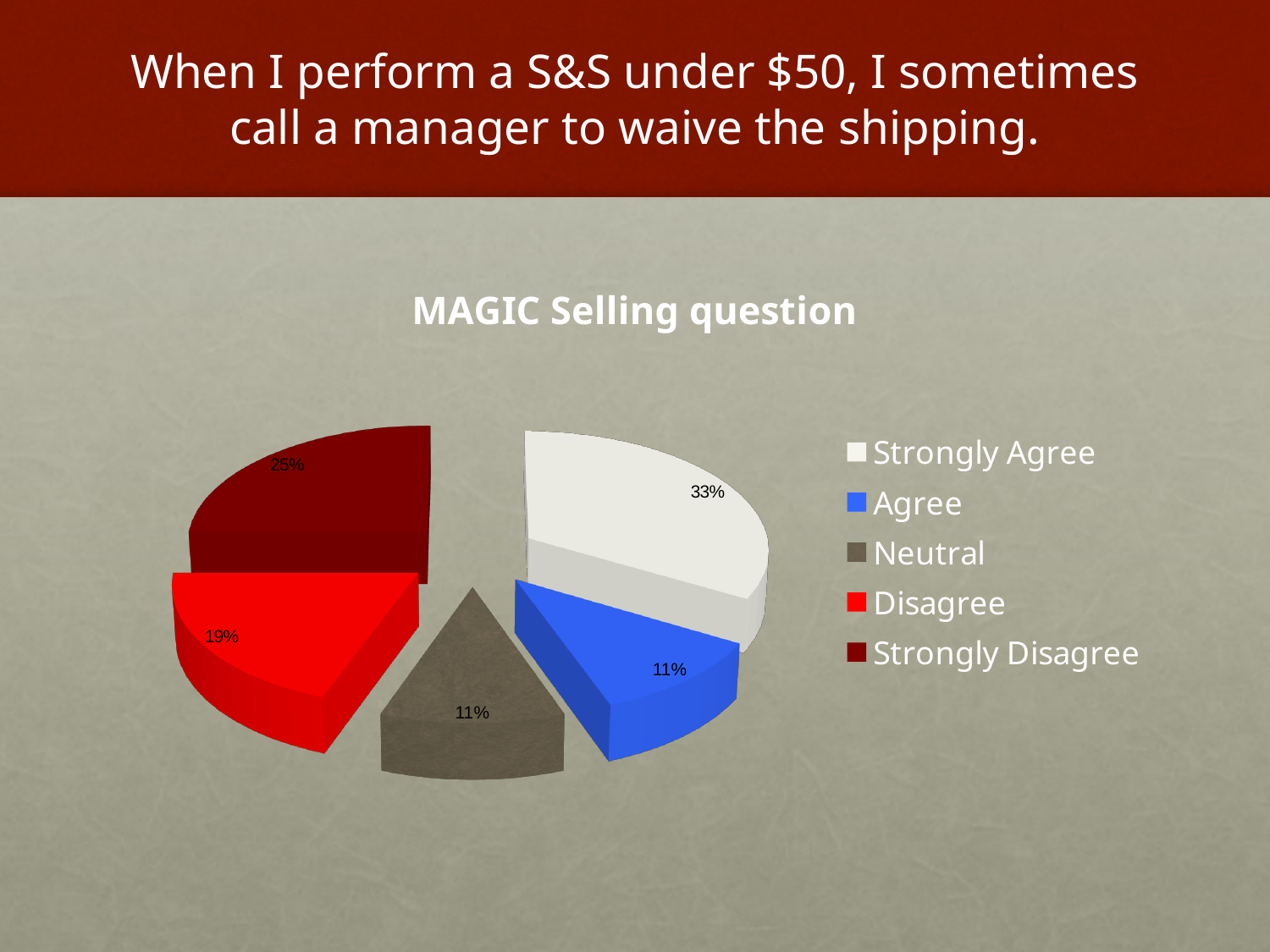
Which is larger, the Disagree share or the Agree share? Disagree What percentage of respondents answered Neutral? 11% What is the combined share of Disagree and Strongly Disagree? 44% How many categories does the legend list? 5 What is the title of the chart? MAGIC Selling question What colour represents the Neutral slice? Grey/brown What kind of chart is shown on the slide? Pie chart What percentage of respondents answered Disagree? 19% What percentage of respondents answered Strongly Agree? 33% What is the difference between the Strongly Agree share and the Strongly Disagree share? 8% Which response category has the largest share of the pie? Strongly Agree What percentage of respondents answered Strongly Disagree? 25%